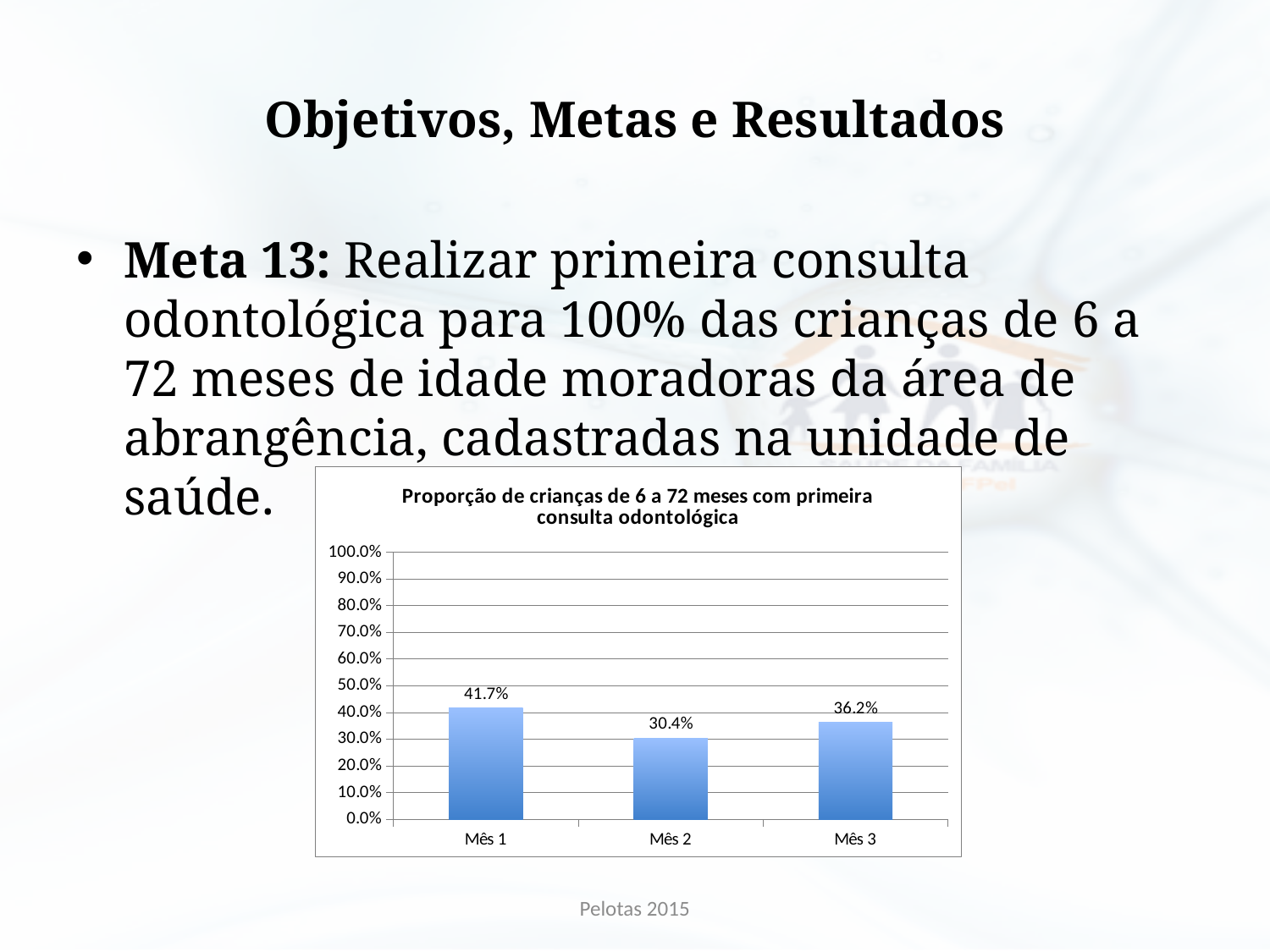
What is the value for Mês 2? 30.4% What is the difference between the values for Mês 3 and Mês 2? 5.8% Which is larger, the value for Mês 1 or the value for Mês 3? Mês 1 What is the title of the chart? Proporção de crianças de 6 a 72 meses com primeira consulta odontológica What kind of chart is shown on the slide? bar chart What is the difference between the values for Mês 1 and Mês 2? 11.3% Which month has the highest proportion? Mês 1 Which month has the lowest proportion? Mês 2 Is the value for Mês 2 greater or less than 40.0%? less How many months are shown on the x axis? 3 What is the value for Mês 1? 41.7% What is the value for Mês 3? 36.2%